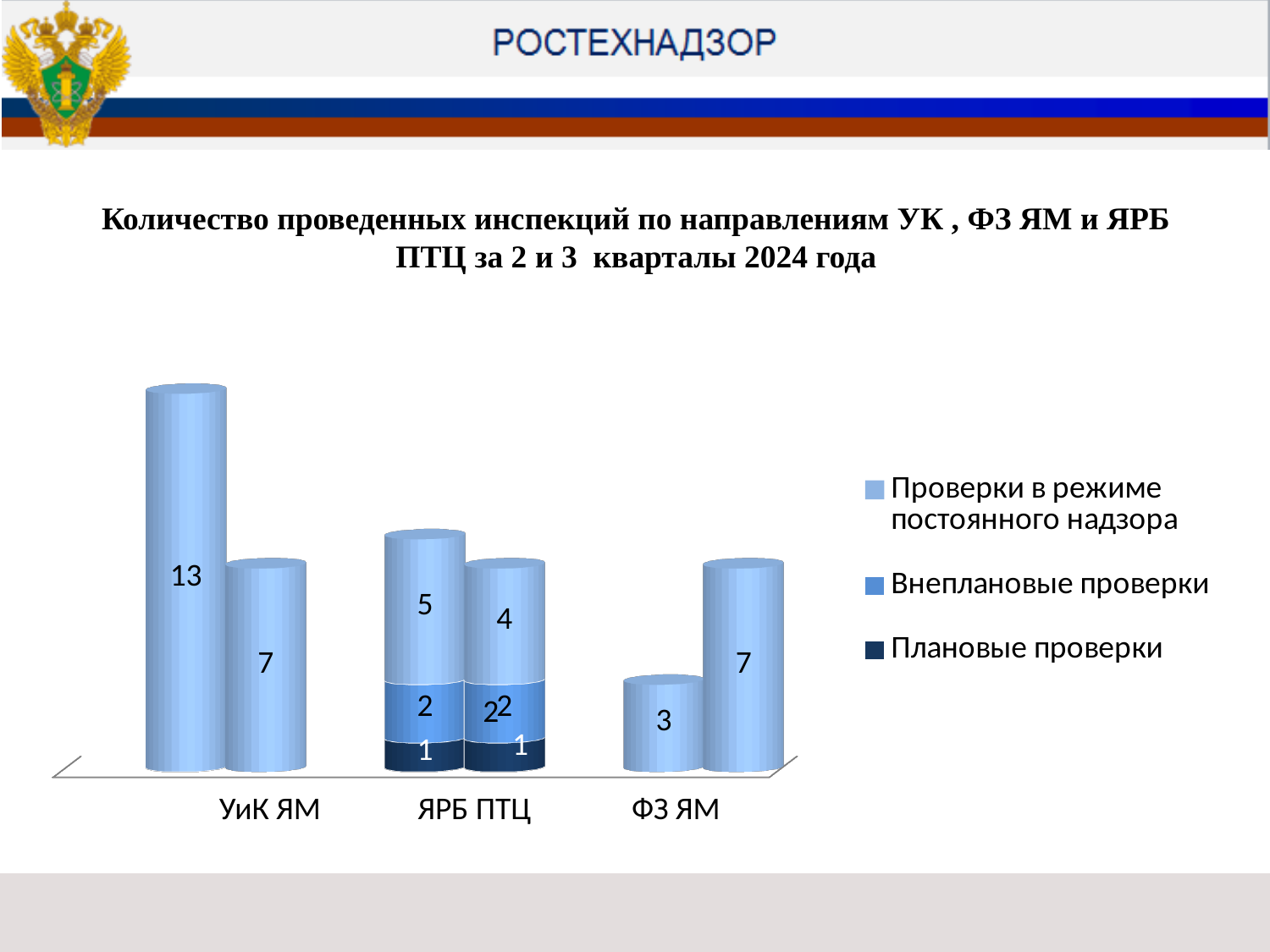
What kind of chart is shown on the slide? bar chart How many series does the legend list? 3 What is the total of the left stacked bar for ЯРБ ПТЦ? 8 How many categories are shown on the x axis? 3 What is the total of the right stacked bar for ЯРБ ПТЦ? 7 What is the value of 'Проверки в режиме постоянного надзора' for the right bar of УиК ЯМ? 7 For ФЗ ЯМ, which bar is larger, the left bar or the right bar? the right bar What is the value of 'Проверки в режиме постоянного надзора' for the left bar of ФЗ ЯМ? 3 Which category has the tallest bar? УиК ЯМ What is the value of 'Плановые проверки' in the left bar of ЯРБ ПТЦ? 1 What is the value of 'Проверки в режиме постоянного надзора' for the left bar of УиК ЯМ? 13 What is the difference between the left bar (13) and the right bar (7) for УиК ЯМ? 6